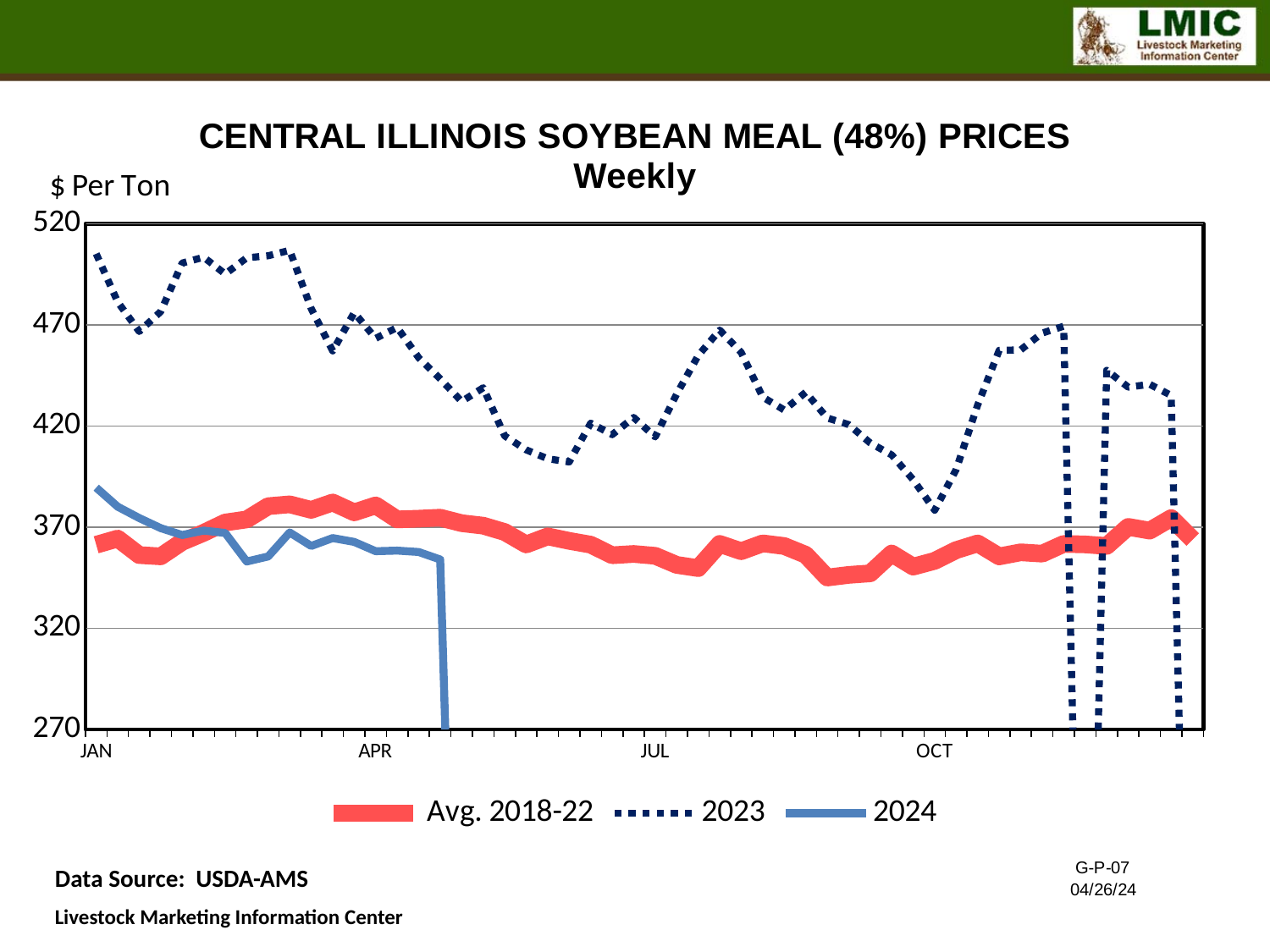
Is the 2024 value in early April greater or less than 370? less Does the 2024 line rise or fall from January to April? fall Which series has the higher value at the start of January, 2024 or Avg. 2018-22? 2024 What is the title of the chart? CENTRAL ILLINOIS SOYBEAN MEAL (48%) PRICES Weekly What unit is shown on the y axis label? $ Per Ton Is the 2023 value at the start of January greater or less than 470? greater Which series has the highest values across the year? 2023 Which series has the higher value at the start of January, 2023 or 2024? 2023 Is the 2023 value in late September greater or less than 420? less How many series does the legend list? 3 What kind of chart is shown on the slide? line chart